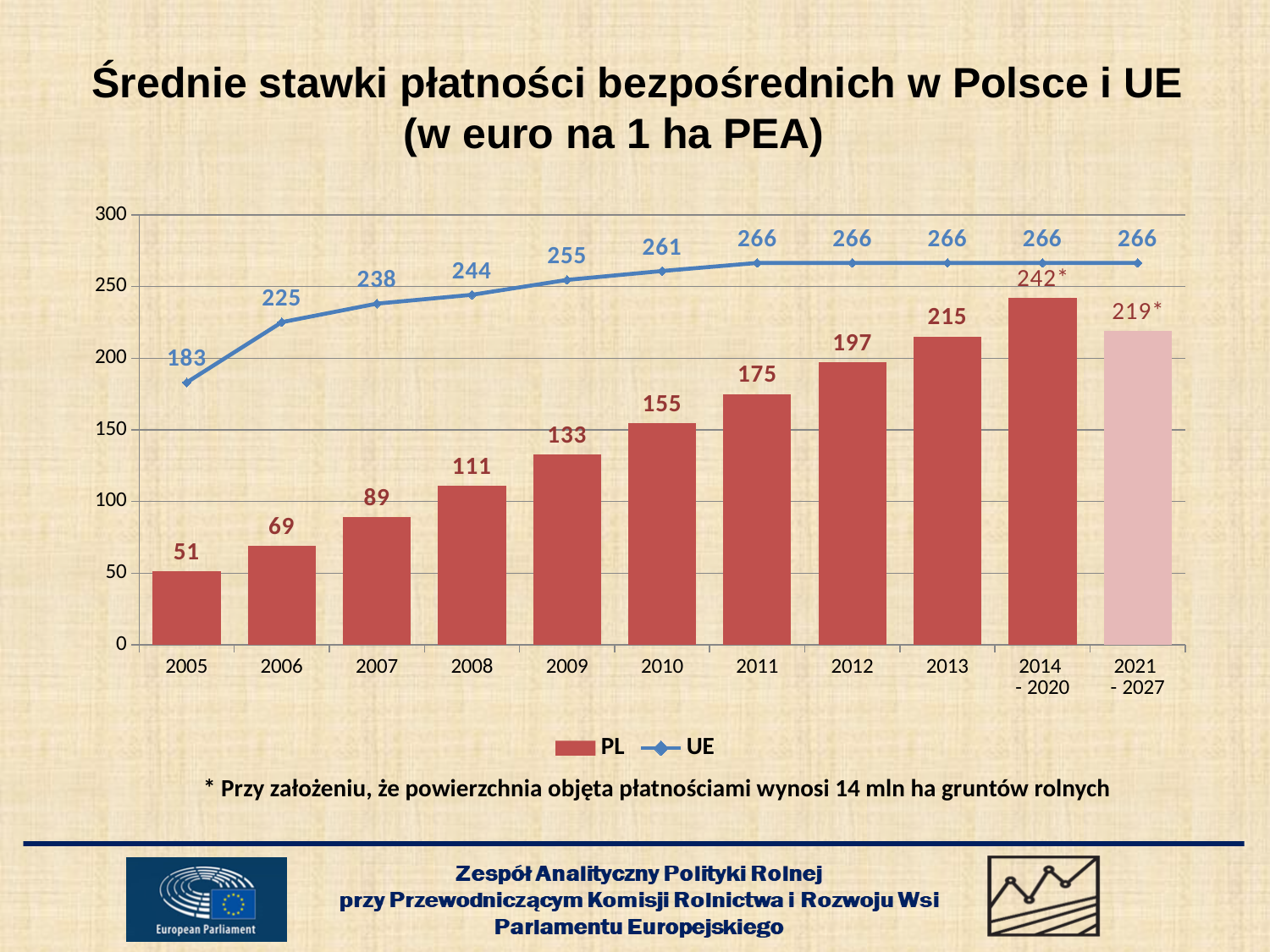
Do the PL values rise or fall from 2005 to 2013? Rise Which category has the highest PL value? 2014 - 2020 Which year has the lowest PL value? 2005 How many categories are shown on the x axis? 11 What is the PL value for 2009? 133 What kind of chart is shown on the slide? Combined bar and line chart What is the UE value for 2011? 266 What is the UE value for 2005? 183 Which is larger in 2013, the PL value or the UE value? UE What is the difference between the UE and PL values in 2010? 106 How many series does the legend list? 2 What is the PL value for 2014 - 2020? 242*